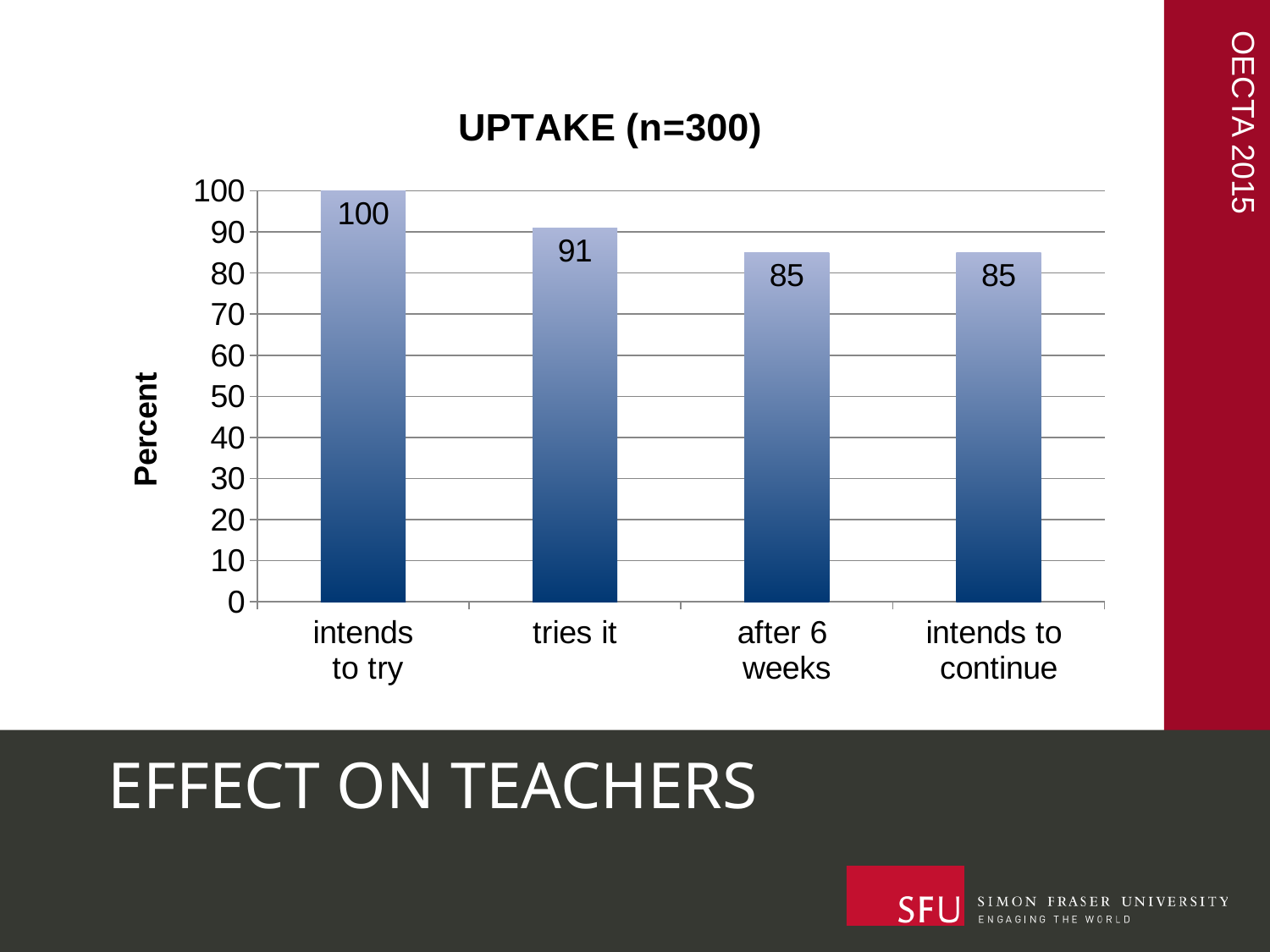
What is the difference between the values for 'intends to try' and 'tries it'? 9 What is the value for 'intends to continue'? 85 What is the value for 'tries it'? 91 What is the value for 'after 6 weeks'? 85 Which is larger, the value for 'tries it' or the value for 'intends to continue'? tries it What is the title of the chart? UPTAKE (n=300) What is the difference between the values for 'tries it' and 'after 6 weeks'? 6 How many categories are shown on the x axis? 4 Which category has the highest value? intends to try What kind of chart is this? bar chart Do the values rise or fall from 'intends to try' to 'after 6 weeks'? fall What is the value for 'intends to try'? 100